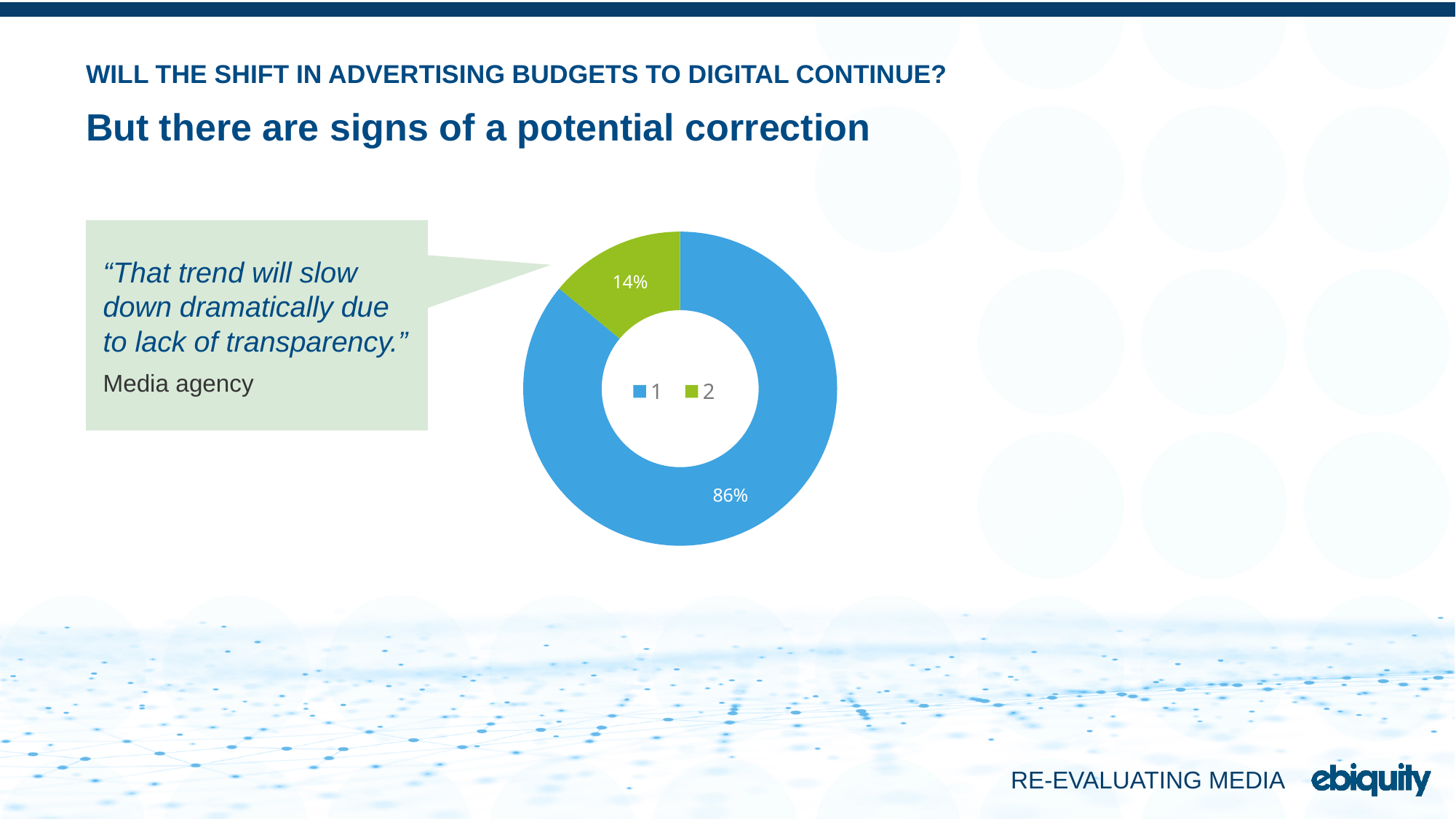
Which category has the smallest share in the doughnut chart? 2 What kind of chart is shown on the slide? Doughnut chart What is the value for category 1 in the doughnut chart? 86% What colour is the segment for category 1 in the doughnut chart? Blue What is the value for category 2 in the doughnut chart? 14% How many categories are shown in the doughnut chart? 2 What colour is the segment for category 2 in the doughnut chart? Green Which is larger, the share for category 1 or category 2? 1 How many entries does the legend of the doughnut chart list? 2 What is the total of the two shares shown in the doughnut chart? 100% Which category has the largest share in the doughnut chart? 1 What is the difference between the shares of category 1 and category 2? 72%